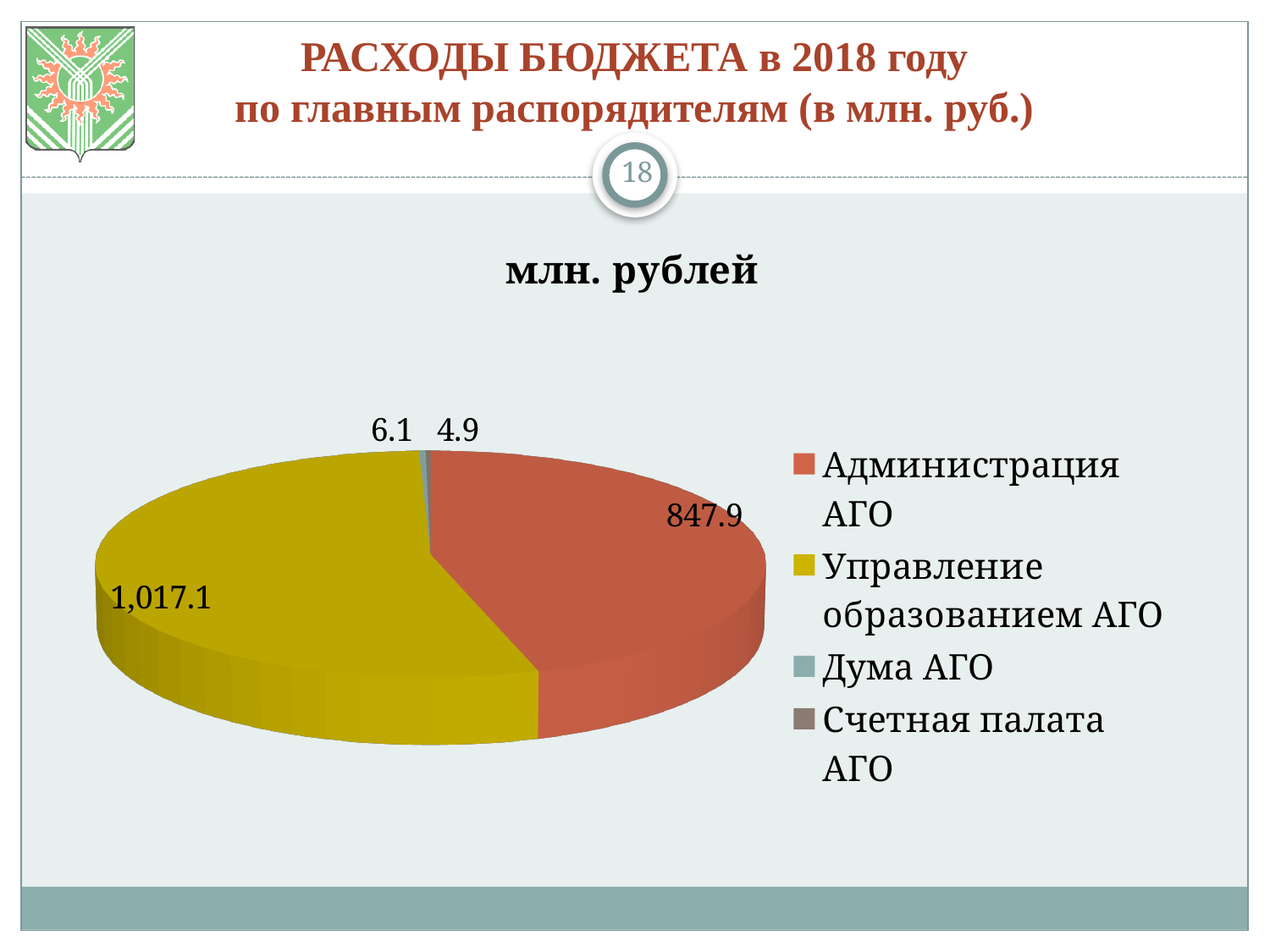
What is the value for Администрация АГО? 847.9 How many categories does the pie chart show? 4 What is the difference between the values for Управление образованием АГО and Администрация АГО? 169.2 What kind of chart is shown on the slide? pie chart What is the value for Дума АГО? 6.1 Which category has the smallest slice of the pie? Счетная палата АГО What is the value for Счетная палата АГО? 4.9 What colour is the slice for Администрация АГО? red Which category has the largest slice of the pie? Управление образованием АГО What is the value for Управление образованием АГО? 1,017.1 Which is larger, the value for Администрация АГО or the value for Управление образованием АГО? Управление образованием АГО What is the title of the chart? млн. рублей